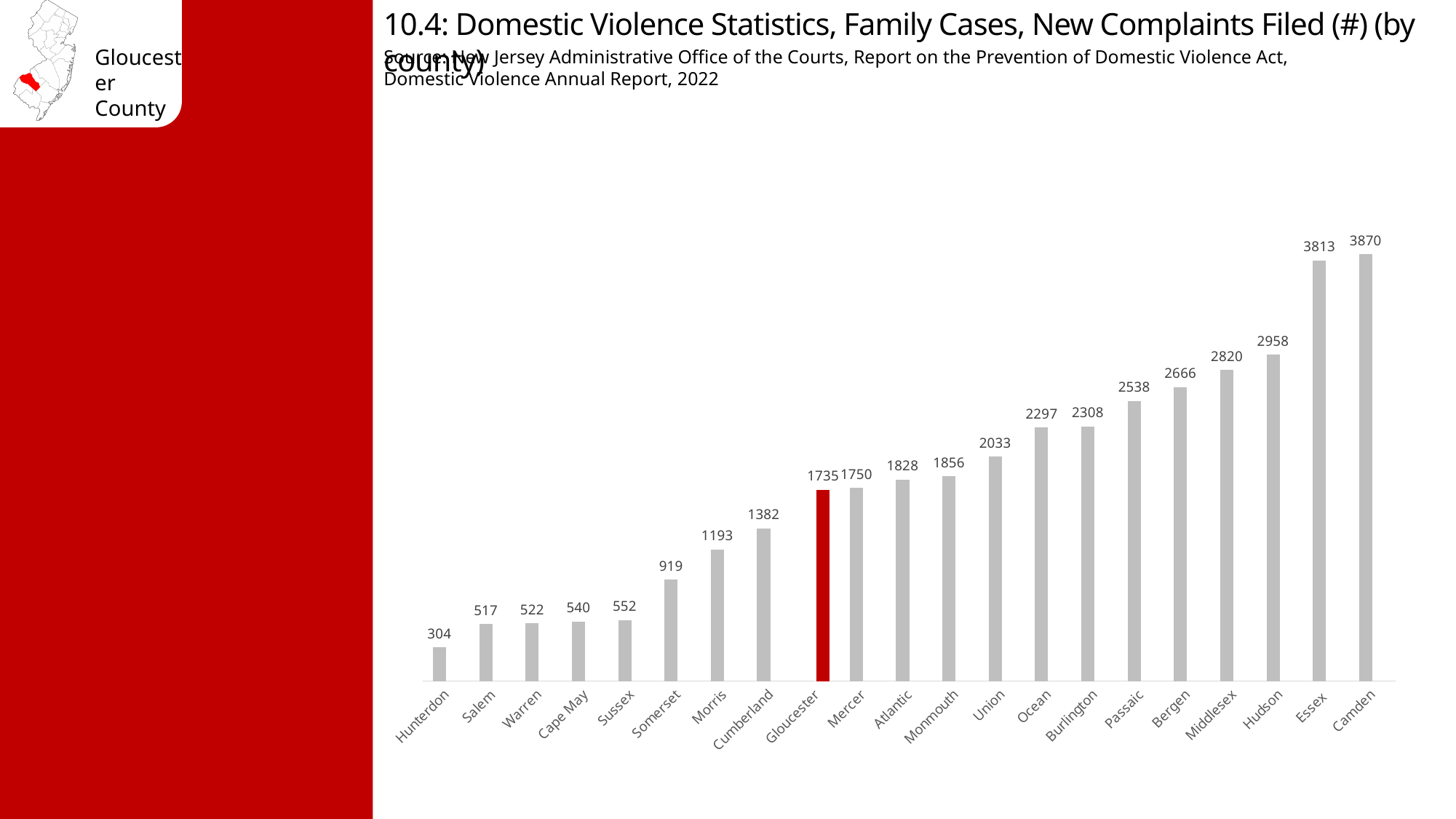
What is the value for Hunterdon? 304 What is the difference between the values for Hudson and Middlesex? 138 Which county has the lowest value? Hunterdon How many counties are shown on the chart? 21 Do the values rise or fall from left to right along the x axis? Rise What is the value for Essex? 3813 What kind of chart is shown on the slide? Bar chart Which county has the highest value? Camden What is the value for Gloucester? 1735 Which is larger, the value for Union or the value for Cumberland? Union What is the value for Somerset? 919 What is the difference between the values for Camden and Gloucester? 2135